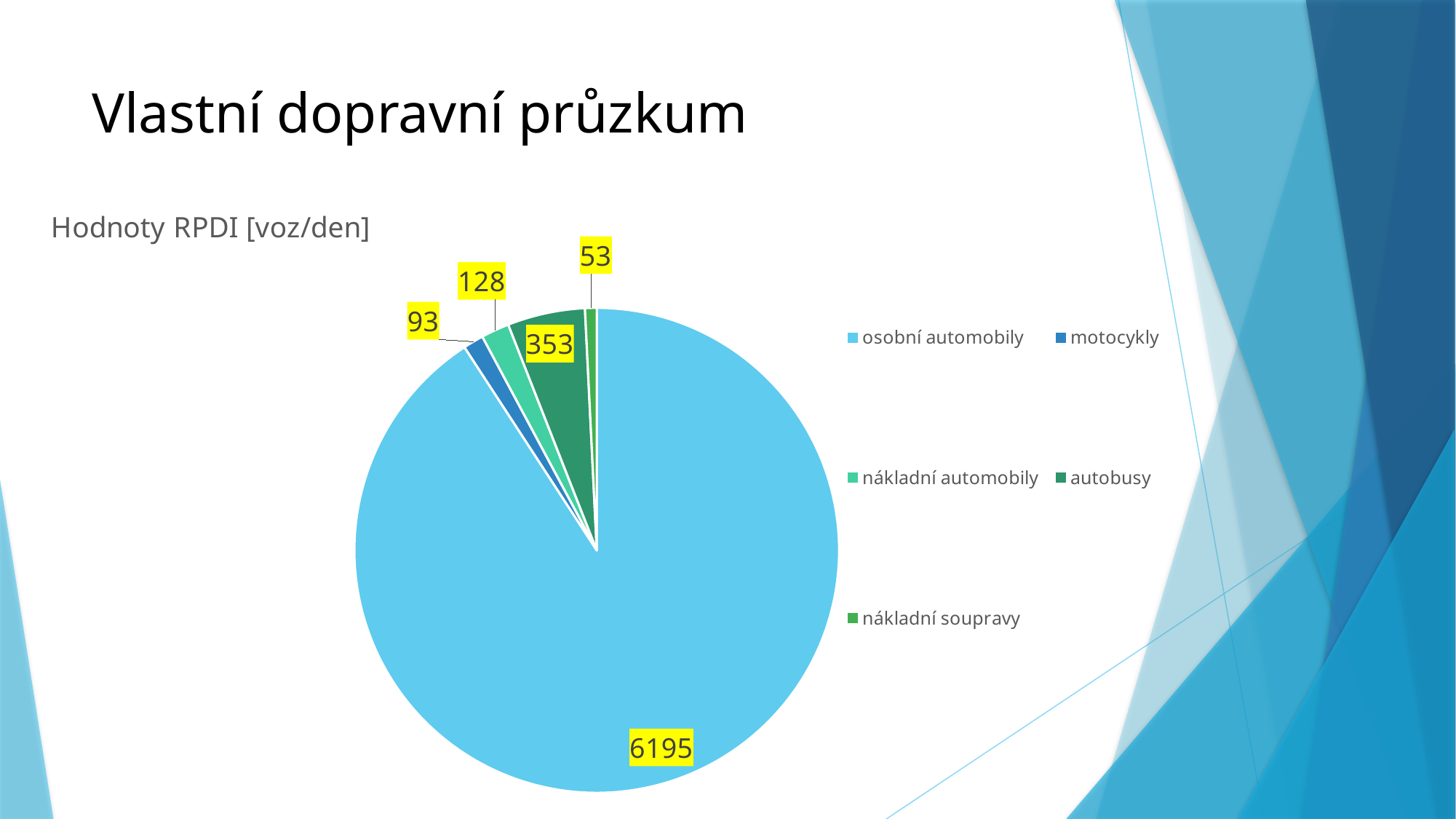
What type of chart is shown on the slide? pie chart What is the value for osobní automobily in the pie chart? 6195 What is the value for autobusy in the pie chart? 353 What is the difference between the values for autobusy and nákladní automobily? 225 What is the value for motocykly in the pie chart? 93 Which is larger, the value for autobusy or the value for nákladní automobily? autobusy What is the title of the chart? Hodnoty RPDI [voz/den] What is the value for nákladní soupravy in the pie chart? 53 What is the difference between the values for nákladní automobily and motocykly? 35 How many categories does the pie chart show? 5 Which category has the smallest slice in the pie chart? nákladní soupravy Which category has the largest slice in the pie chart? osobní automobily